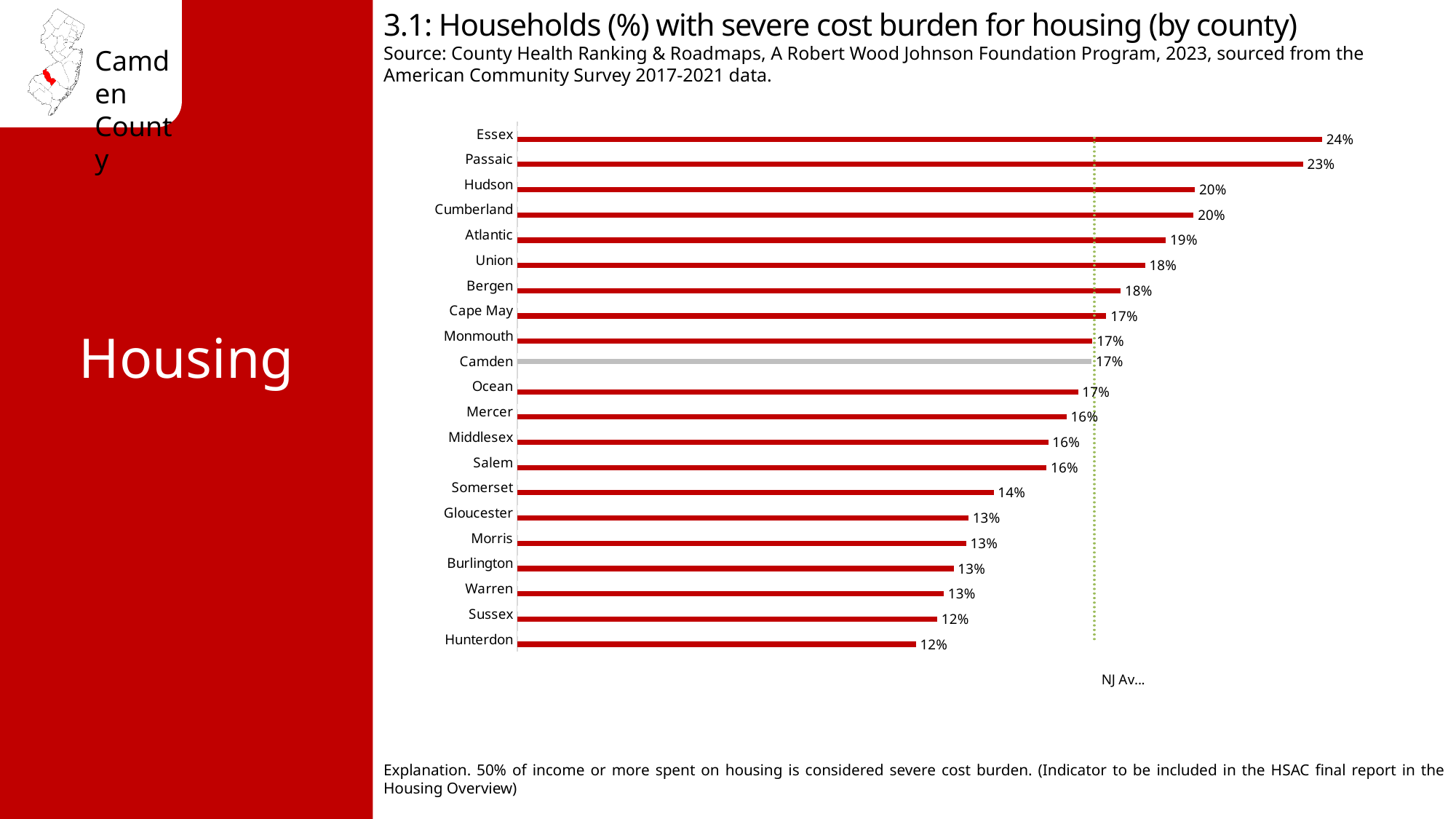
What is the value for Essex? 24% Which county has the highest percentage of households with severe cost burden? Essex What is the value for Somerset? 14% What kind of chart is shown on the slide? Bar chart Which has a larger value, Gloucester or Hudson? Hudson Which county's bar is drawn in grey instead of red? Camden What is the value for Hunterdon? 12% How many counties are shown in the chart? 21 What is the difference between the values for Essex and Camden? 7 percentage points What is the difference between the values for Passaic and Hunterdon? 11 percentage points Which has a larger value, Atlantic or Somerset? Atlantic What is the value for Camden? 17%